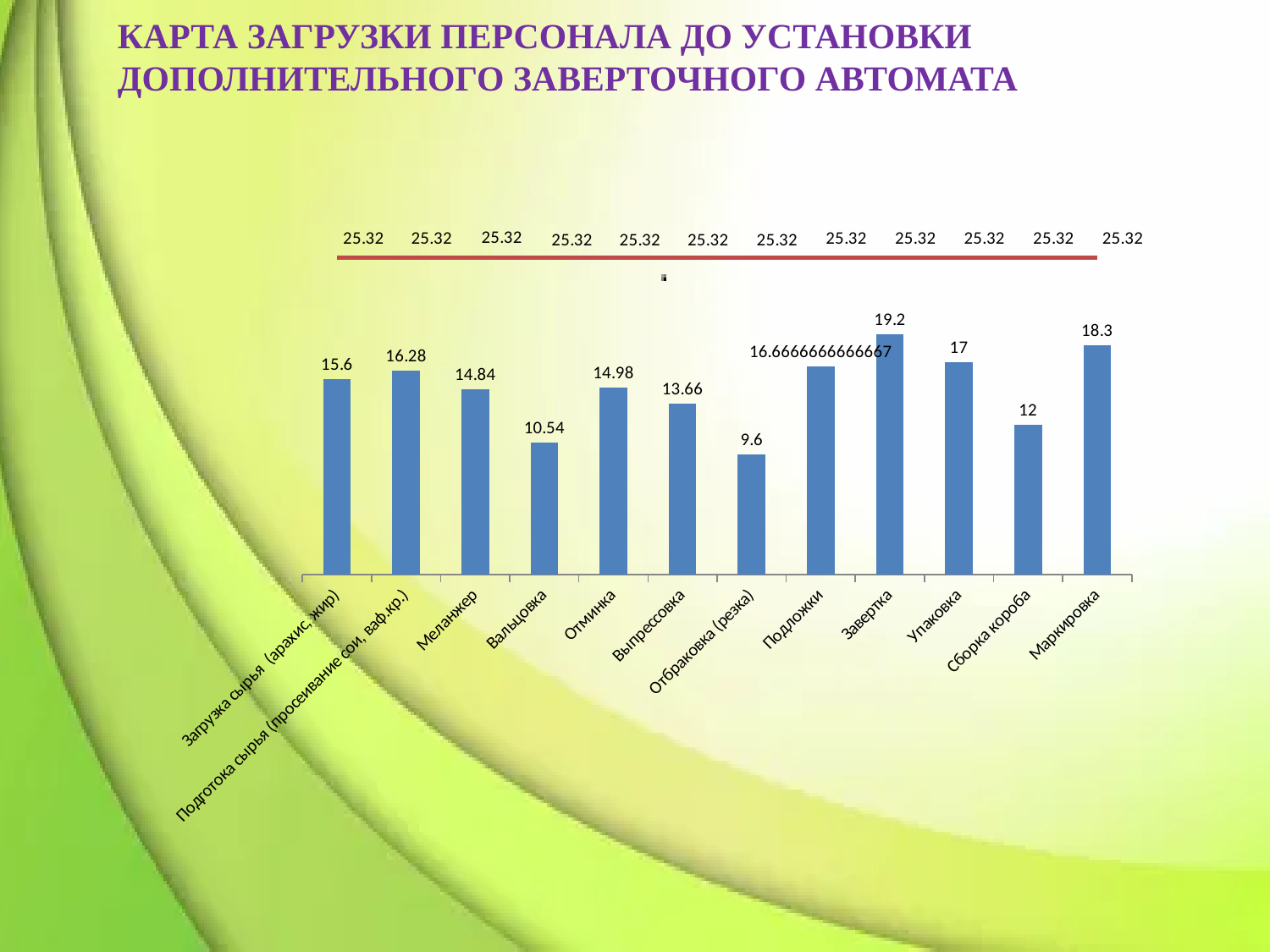
How many categories are shown on the x axis? 12 What is the value for Сборка короба? 12 What constant value does the red line across the top of the chart show? 25.32 What is the difference between the values for Упаковка and Сборка короба? 5 Which category has the highest bar? Завертка What is the value for Завертка? 19.2 What kind of chart is shown on the slide? Bar chart What is the value for Маркировка? 18.3 What is the value for Вальцовка? 10.54 What is the difference between the values for Завертка and Отбраковка (резка)? 9.6 Which is larger, the value for Меланжер or the value for Отминка? Отминка Which category has the lowest bar? Отбраковка (резка)